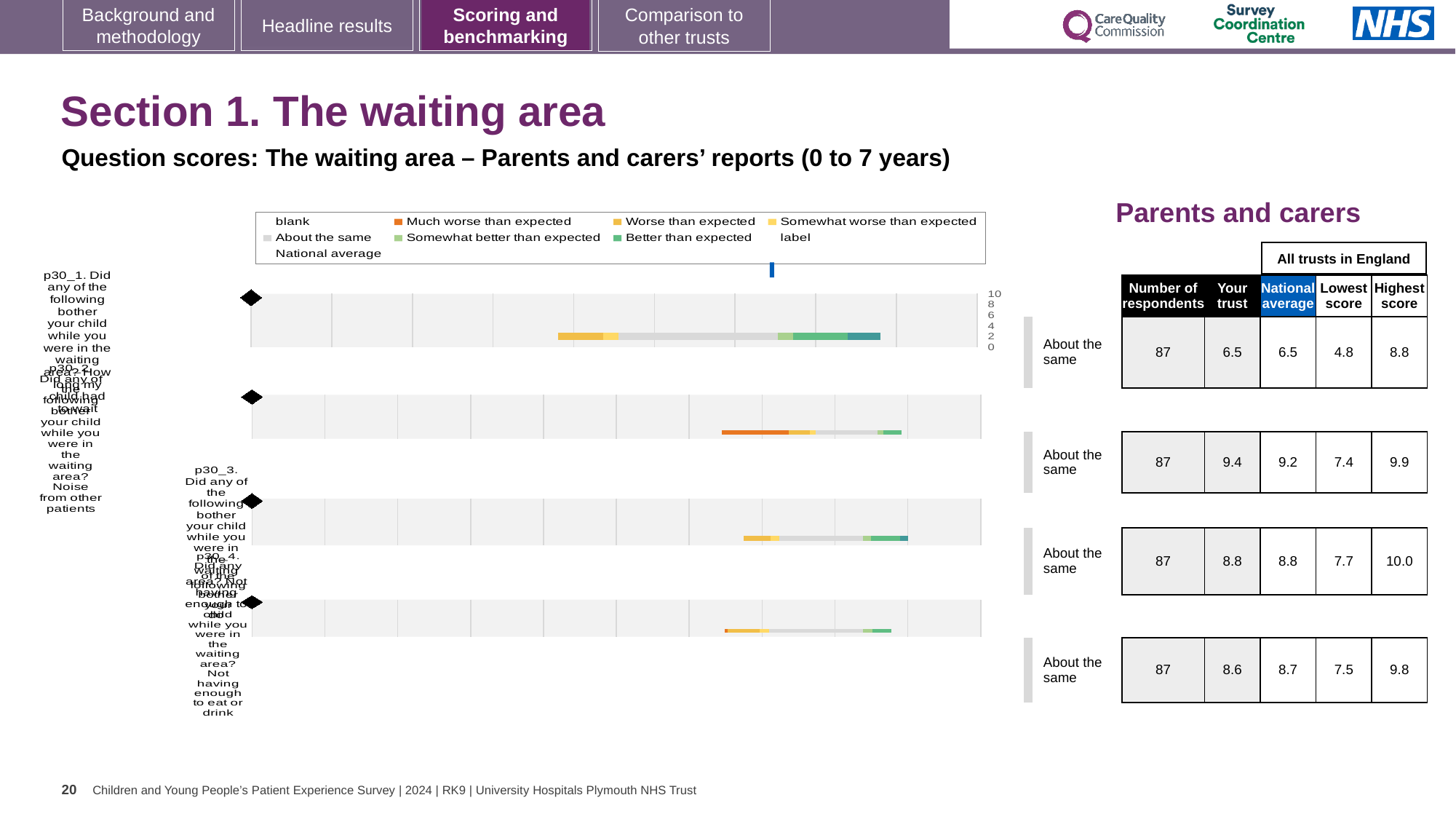
In the table beside the chart, how many respondents are listed for each question row? 87 In the table beside the chart, what is the 'Your trust' score for the first row (p30_1)? 6.5 Which legend entry is shown in light grey? About the same What kind of chart is shown on the slide? bar chart In the table beside the chart, what is the 'Your trust' score for the second row (p30_2, noise from other patients)? 9.4 In the table beside the chart, which row has the highest 'Your trust' score? p30_2 (noise from other patients), 9.4 In the table beside the chart, what is the 'Lowest score' for the fourth row (p30_4, not having enough to eat or drink)? 7.5 In the table beside the chart, what is the 'Highest score' for the third row (p30_3)? 10.0 How many entries does the chart legend list? 9 In the table beside the chart, what is the difference between the 'Your trust' score and the 'National average' for the second row (p30_2)? 0.2 Which legend entry is shown in dark orange? Much worse than expected How many horizontal bars (question rows) does the chart contain? 4